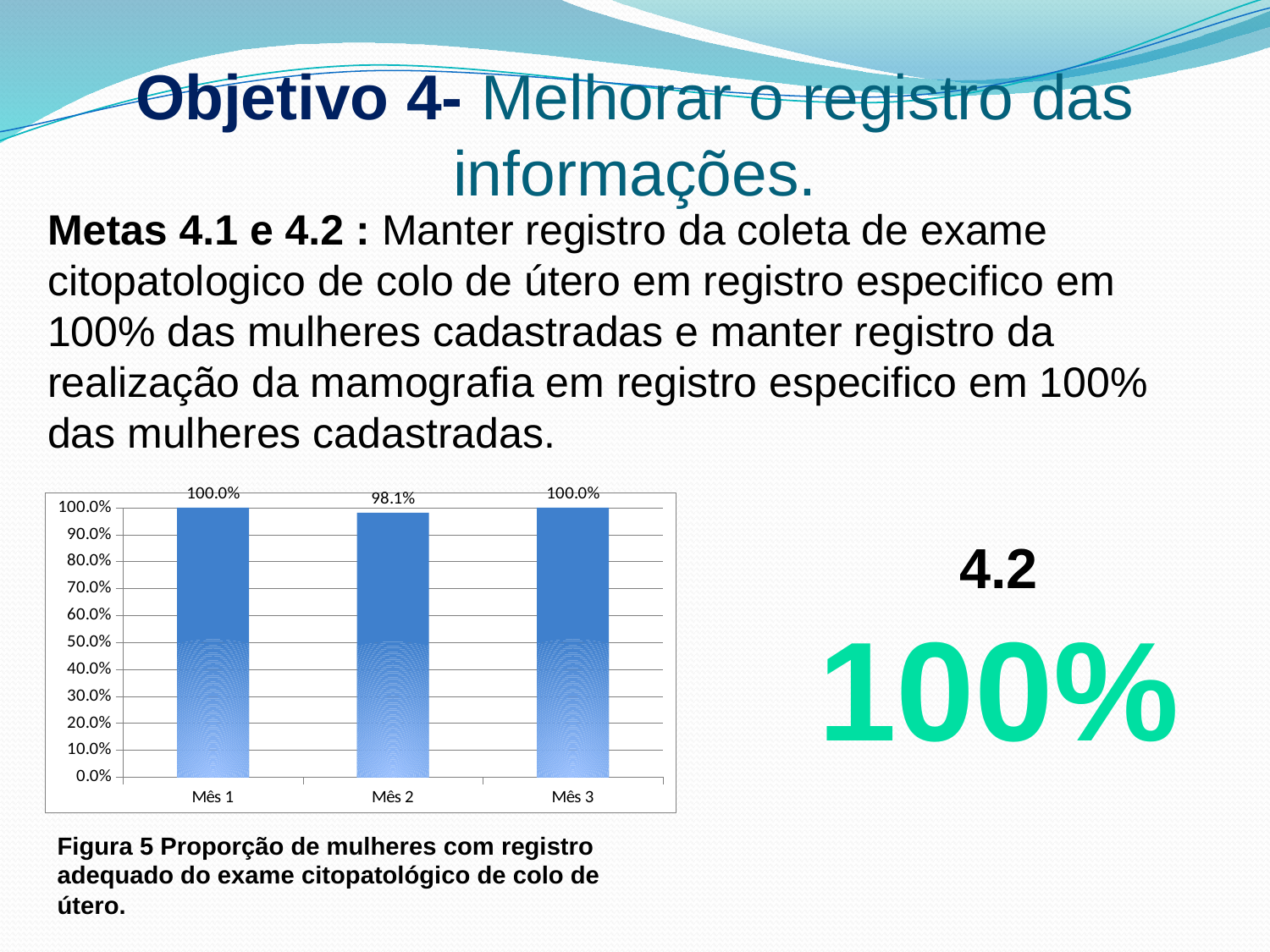
How many categories are shown on the x axis of the chart? 3 What kind of chart is shown on the slide? bar chart What is the value for Mês 3? 100.0% Is the value for Mês 2 greater or less than 90.0%? greater Which is larger, the value for Mês 2 or the value for Mês 3? Mês 3 What is the value for Mês 2? 98.1% What is the value for Mês 1? 100.0% Which month has the lowest value? Mês 2 What is the highest value shown on the y axis of the chart? 100.0% What is the label of the first category on the x axis? Mês 1 What is the difference between the values for Mês 1 and Mês 2? 1.9%